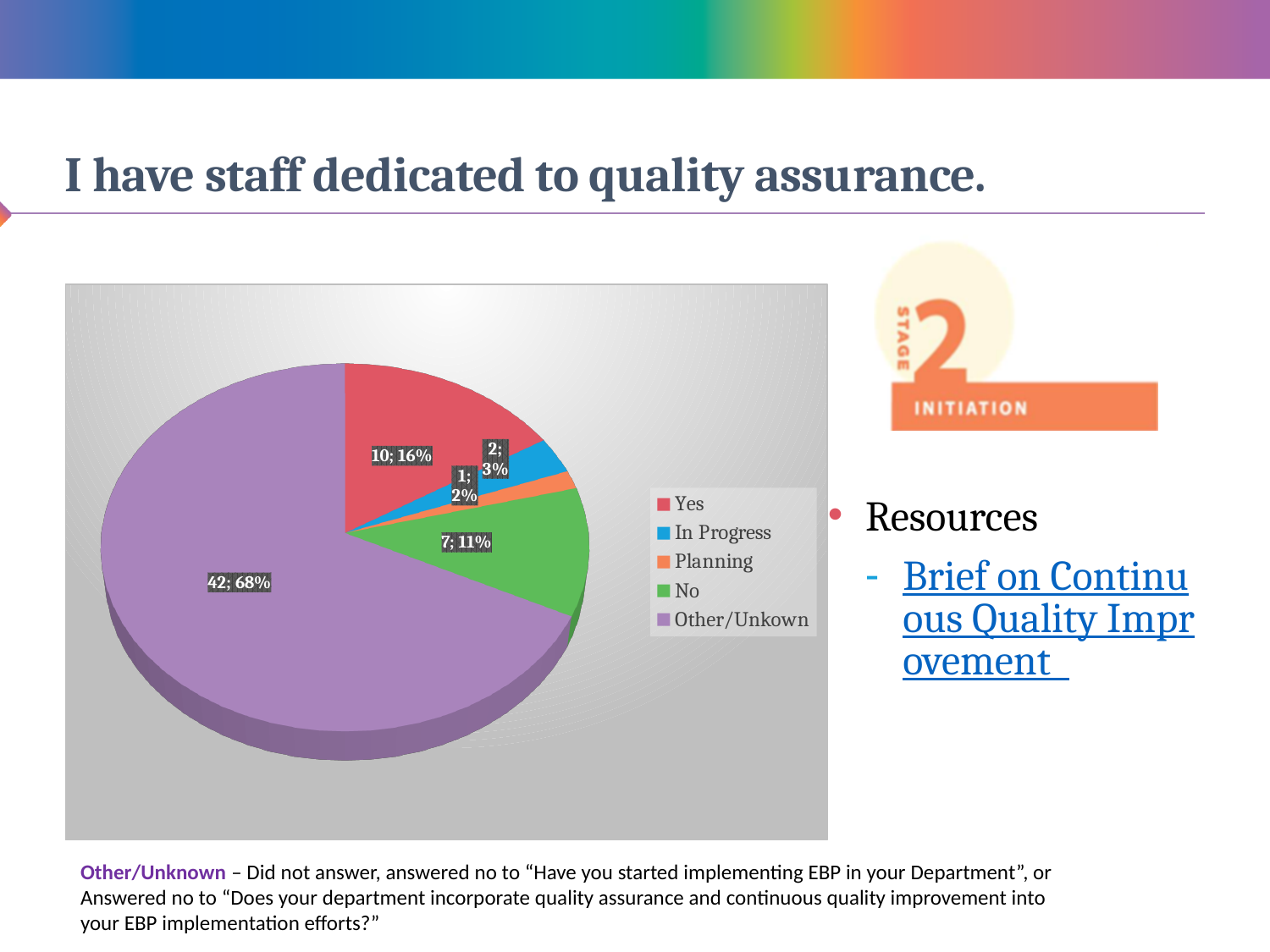
What percentage share does the Other/Unkown slice have? 68% How many categories does the legend of the pie chart list? 5 Which category has the smallest slice of the pie? Planning What percentage share does the In Progress slice have? 3% What colour is the Other/Unkown slice in the pie chart? Purple Which slice is larger, Yes or In Progress? Yes What is the count for the Yes slice of the pie chart? 10 What is the count for the Planning slice? 1 What kind of chart is shown on the slide? Pie chart Which category has the largest slice of the pie? Other/Unkown What is the difference in count between the Yes slice and the No slice? 3 What is the count for the No slice? 7